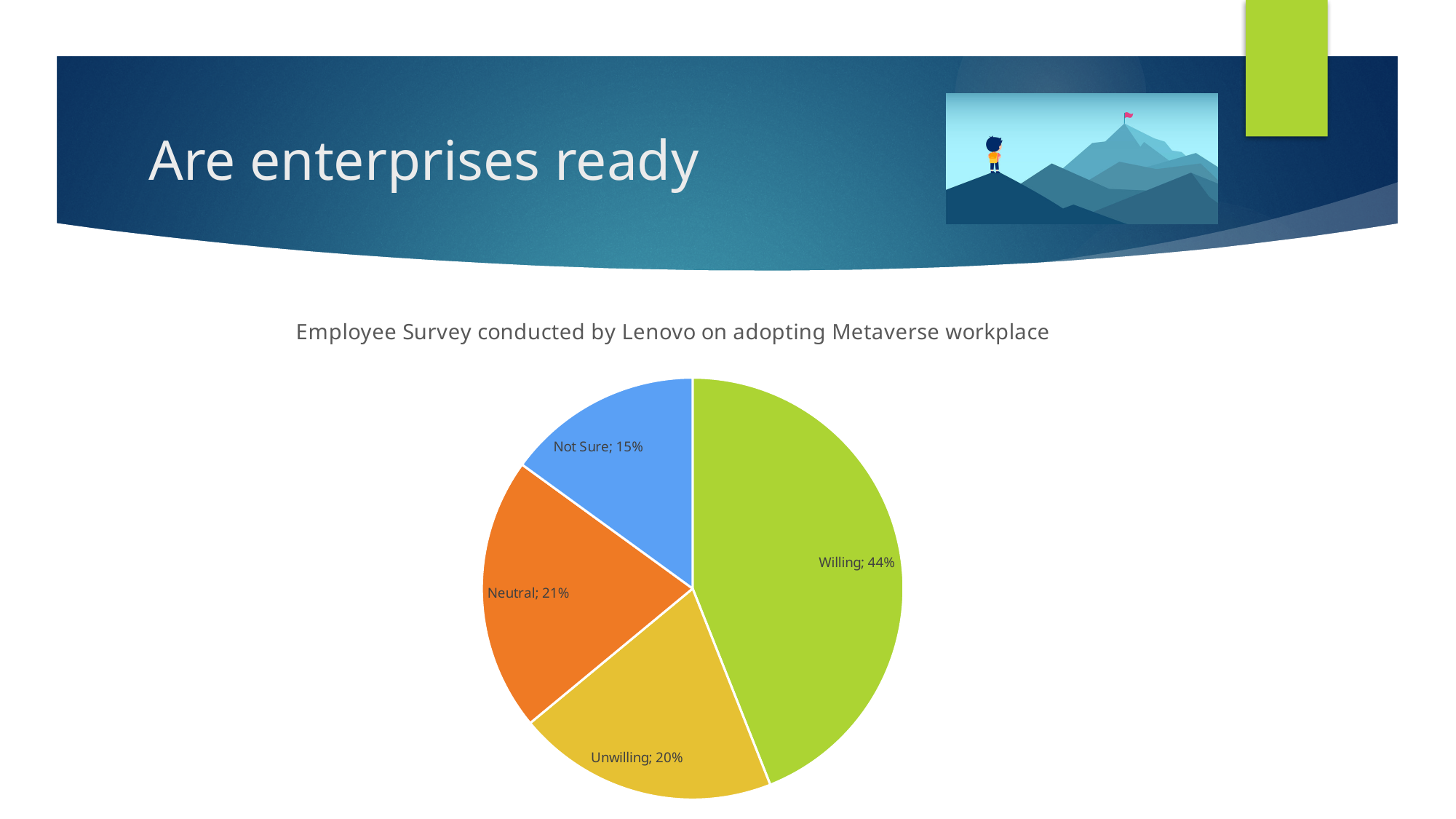
What is the difference in percentage points between Neutral and Not Sure? 6 What percentage of employees are Neutral? 21% What kind of chart is shown on the slide? Pie chart What percentage of employees are Willing? 44% What is the difference in percentage points between Willing and Unwilling? 24 What is the title of the chart? Employee Survey conducted by Lenovo on adopting Metaverse workplace What percentage of employees are Not Sure? 15% Which is larger, the Willing share or the Neutral share? Willing Which category has the smallest share of the pie? Not Sure What percentage of employees are Unwilling? 20% Which category has the largest share of the pie? Willing How many categories are shown in the pie chart? 4